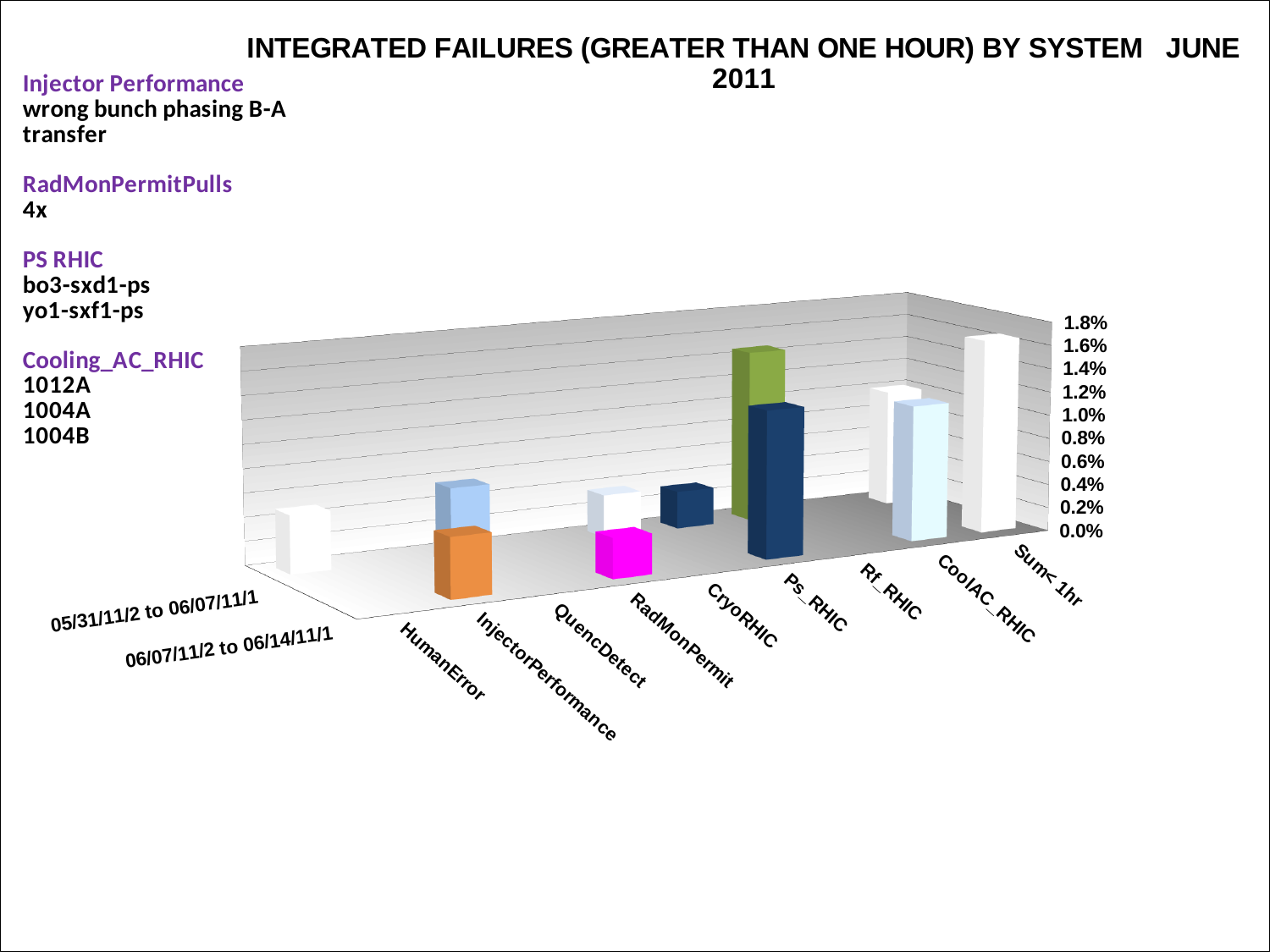
How many date-range series are plotted in the chart? 2 How many system categories are shown along the category axis of the chart? 9 What is the title of the chart? INTEGRATED FAILURES (GREATER THAN ONE HOUR) BY SYSTEM JUNE 2011 What kind of chart is shown on the slide? bar chart What is the highest value shown on the percentage axis of the chart? 1.8% Is the value for CryoRHIC in the 05/31/11/2 to 06/07/11/1 series greater or less than 1.0%? less Is the value for InjectorPerformance in the 06/07/11/2 to 06/14/11/1 series greater or less than 1.0%? less